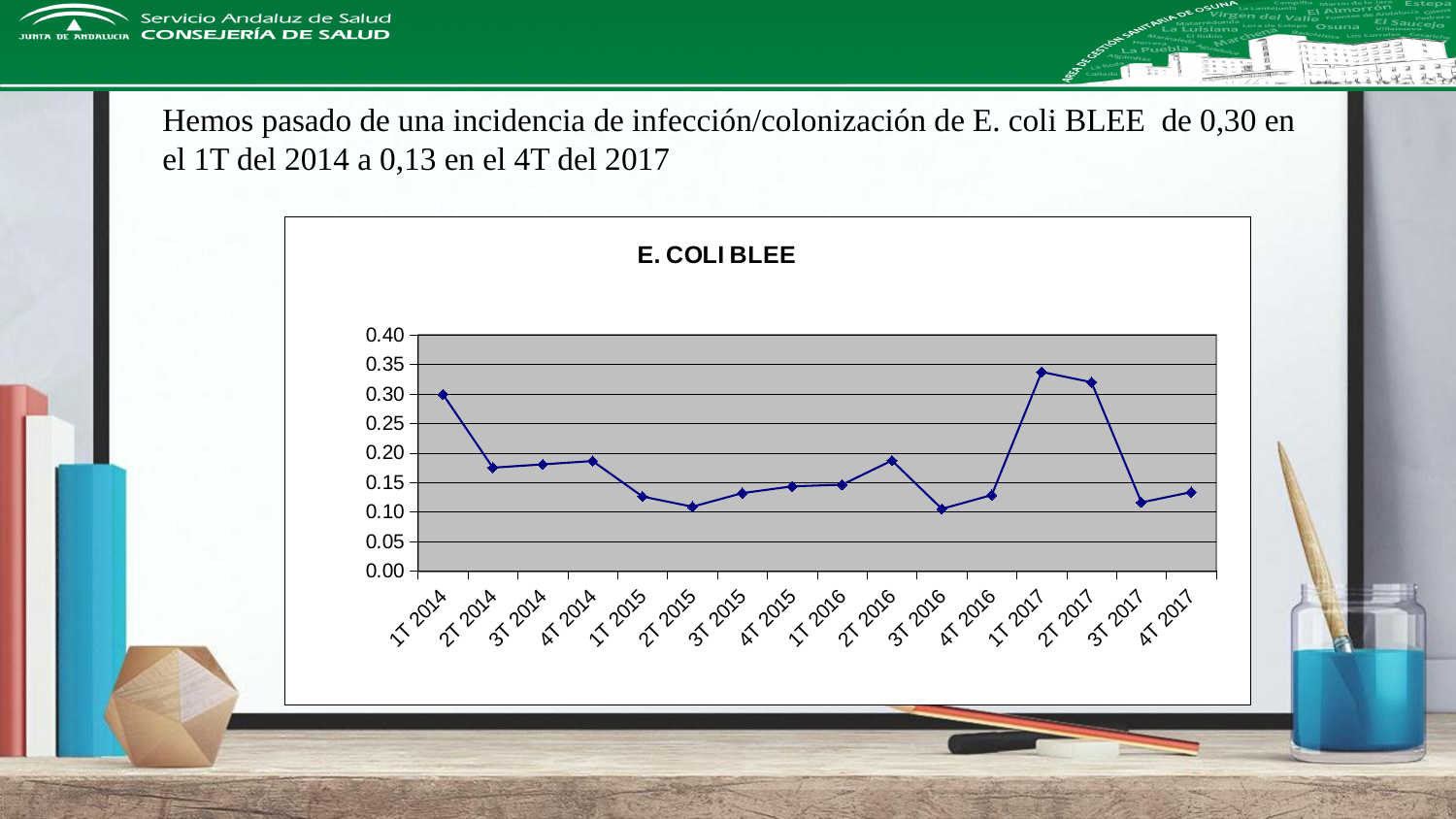
Is the value for 2T 2014 greater or less than 0.20? less What is the title of the chart? E. COLI BLEE What is the value for 1T 2014? 0.30 According to the slide text, what is the incidence value for 4T 2017? 0,13 Is the value for 1T 2017 greater or less than 0.30? greater Is the value for 3T 2016 greater or less than 0.15? less What type of chart is shown on the slide? line chart Do the values rise or fall from 1T 2014 to 1T 2015? fall Which is larger, the value for 2T 2016 or the value for 3T 2016? 2T 2016 Which is larger, the value for 1T 2014 or the value for 4T 2017? 1T 2014 Which quarter has the highest value on the chart? 1T 2017 How many quarterly data points are plotted on the chart? 16